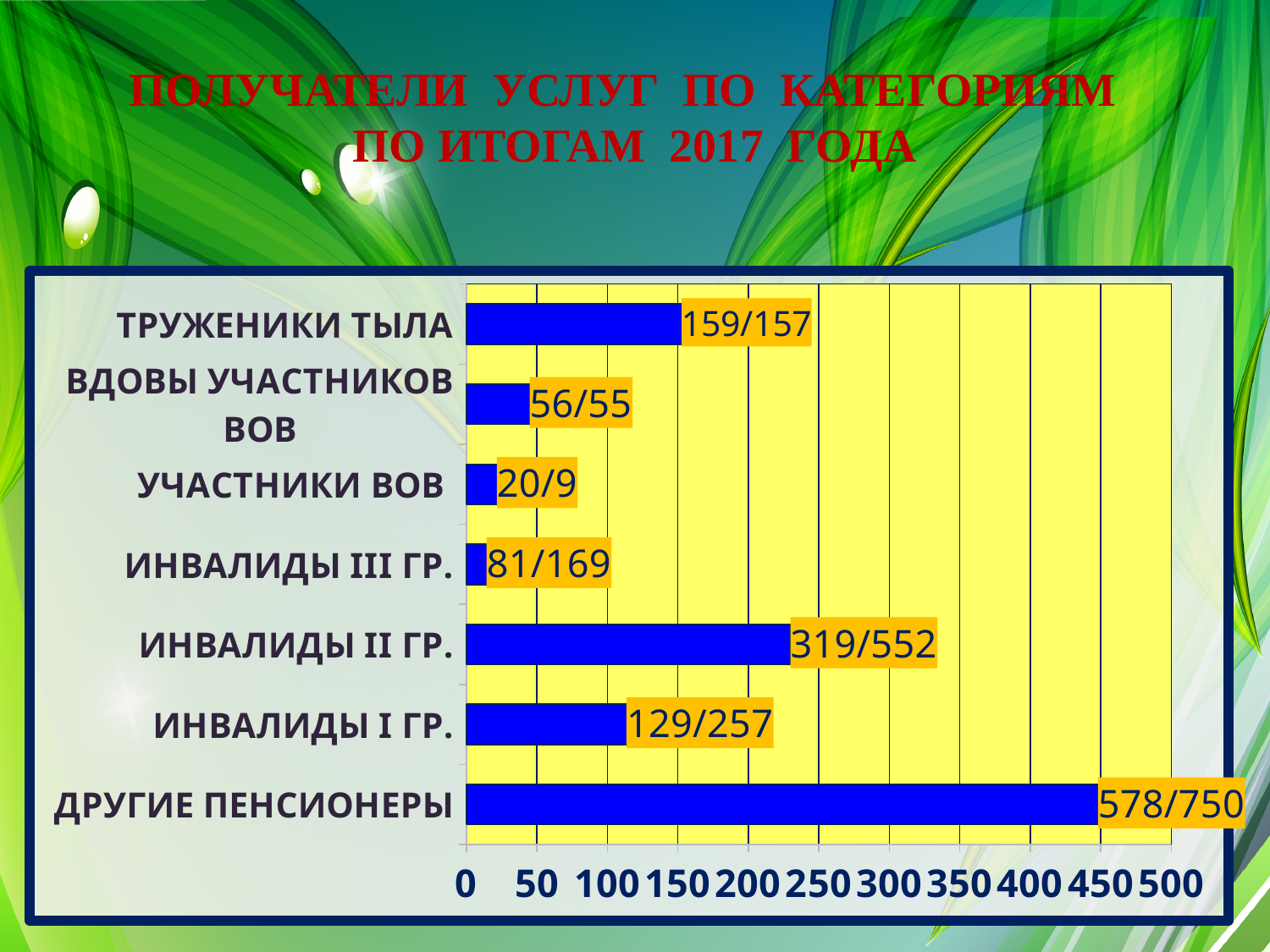
Is the bar for ДРУГИЕ ПЕНСИОНЕРЫ greater or less than 400 on the axis? greater What data label is shown for ИНВАЛИДЫ II ГР.? 319/552 What data label is shown for ТРУЖЕНИКИ ТЫЛА? 159/157 Which bar is longer, ИНВАЛИДЫ II ГР. or ИНВАЛИДЫ I ГР.? ИНВАЛИДЫ II ГР. What data label is shown for ИНВАЛИДЫ I ГР.? 129/257 What data label is shown for УЧАСТНИКИ ВОВ? 20/9 What type of chart is shown on the slide? bar chart What data label is shown for ИНВАЛИДЫ III ГР.? 81/169 What data label is shown for ВДОВЫ УЧАСТНИКОВ ВОВ? 56/55 What data label is shown for ДРУГИЕ ПЕНСИОНЕРЫ? 578/750 How many categories are shown in the chart? 7 Which category has the longest bar? ДРУГИЕ ПЕНСИОНЕРЫ